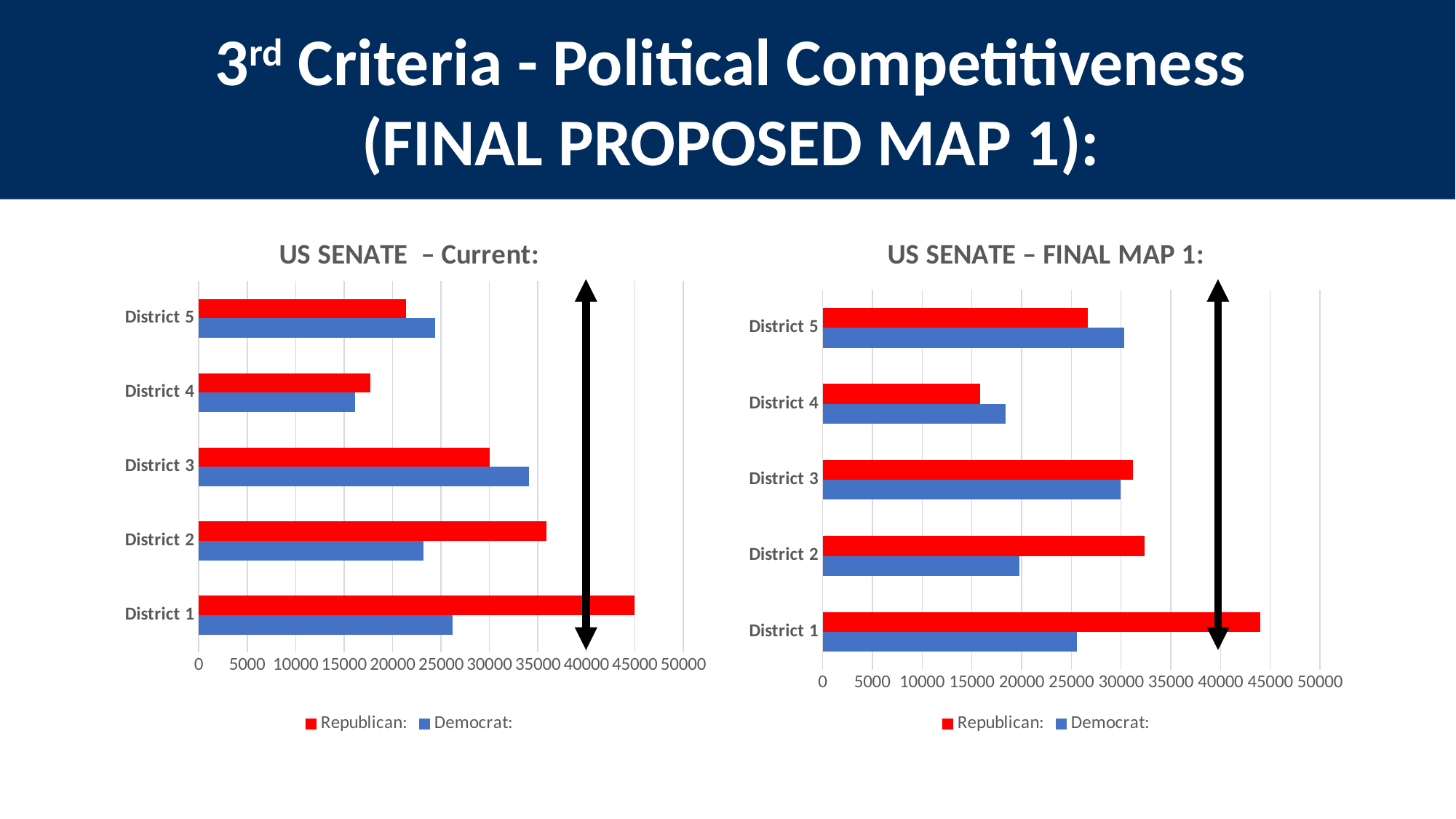
In the "US SENATE – FINAL MAP 1:" chart, is the Democrat value for District 2 greater or less than 25000? less How many districts are shown on the "US SENATE – Current:" chart? 5 What kind of chart is the "US SENATE – Current:" chart? bar chart In the "US SENATE – Current:" chart, for District 3, which is larger: the Republican or the Democrat value? Democrat In the "US SENATE – FINAL MAP 1:" chart, which district has the highest Republican value? District 1 In the "US SENATE – FINAL MAP 1:" chart, which district has the lowest Republican value? District 4 In the "US SENATE – Current:" chart, which district has the lowest Democrat value? District 4 In the "US SENATE – FINAL MAP 1:" chart, for District 2, which is larger: the Republican or the Democrat value? Republican In the "US SENATE – Current:" chart, is the Republican value for District 1 greater or less than 40000? greater How many series does the legend of the "US SENATE – FINAL MAP 1:" chart list? 2 In the "US SENATE – Current:" chart, is the Democrat value for District 4 greater or less than 20000? less In the "US SENATE – Current:" chart, which district has the highest Republican value? District 1